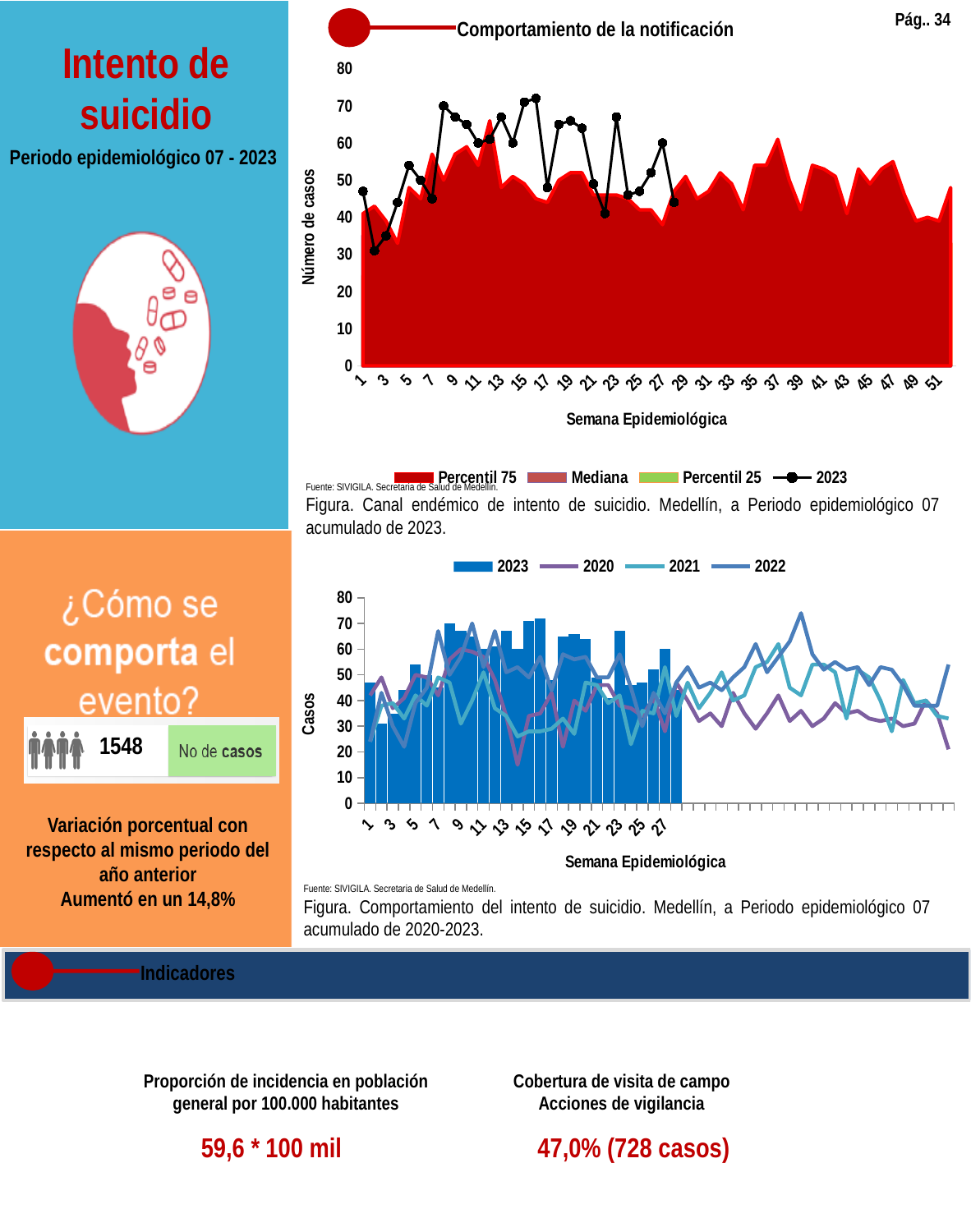
In the top chart, is the 2023 value at week 16 greater or less than 60? greater In the bottom chart, how many series does the legend list? 4 In the top chart, is the 2023 value at week 22 greater or less than 50? less In the bottom chart, is the 2023 bar at week 2 greater or less than 40? less In the top chart, does the 2023 line rise or fall from week 1 to week 2? fall In the top chart, how many entries does the legend list? 4 In the bottom chart, which series is drawn as bars rather than lines? 2023 What is the title of the top chart? Comportamiento de la notificación